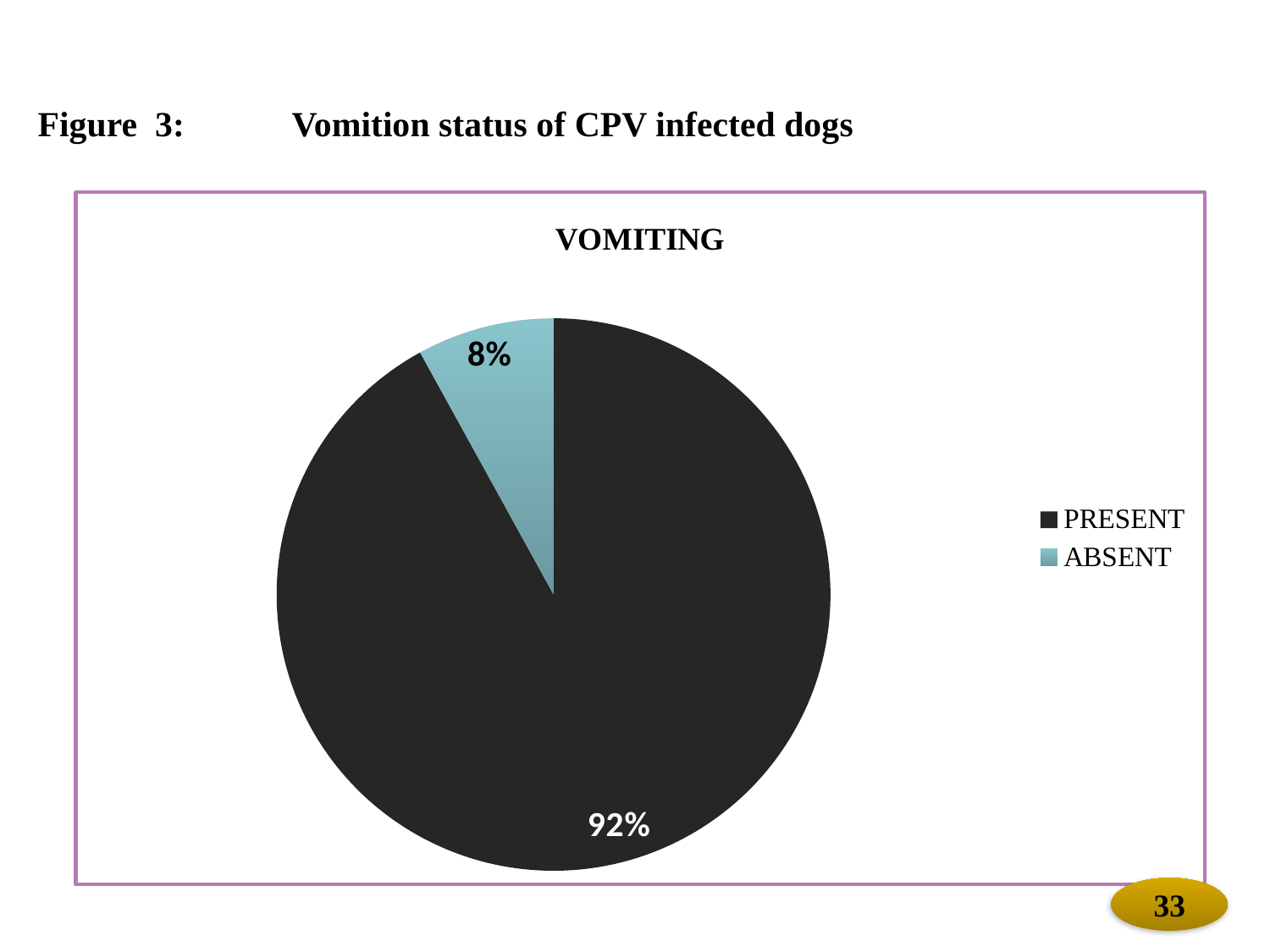
What is the difference in percentage points between the PRESENT and ABSENT slices? 84 Which slice is larger, PRESENT or ABSENT? PRESENT What share of the pie does the ABSENT slice represent? 8% What is the title of the chart? VOMITING How many slices does the pie chart have? 2 What percentage of CPV infected dogs had vomiting present? 92% Which legend entry is shown in the teal/blue colour? ABSENT Which category has the smallest share of the pie? ABSENT What percentage of CPV infected dogs had vomiting absent? 8% How many entries does the legend list? 2 Which category has the largest share of the pie? PRESENT What type of chart is shown on the slide? pie chart